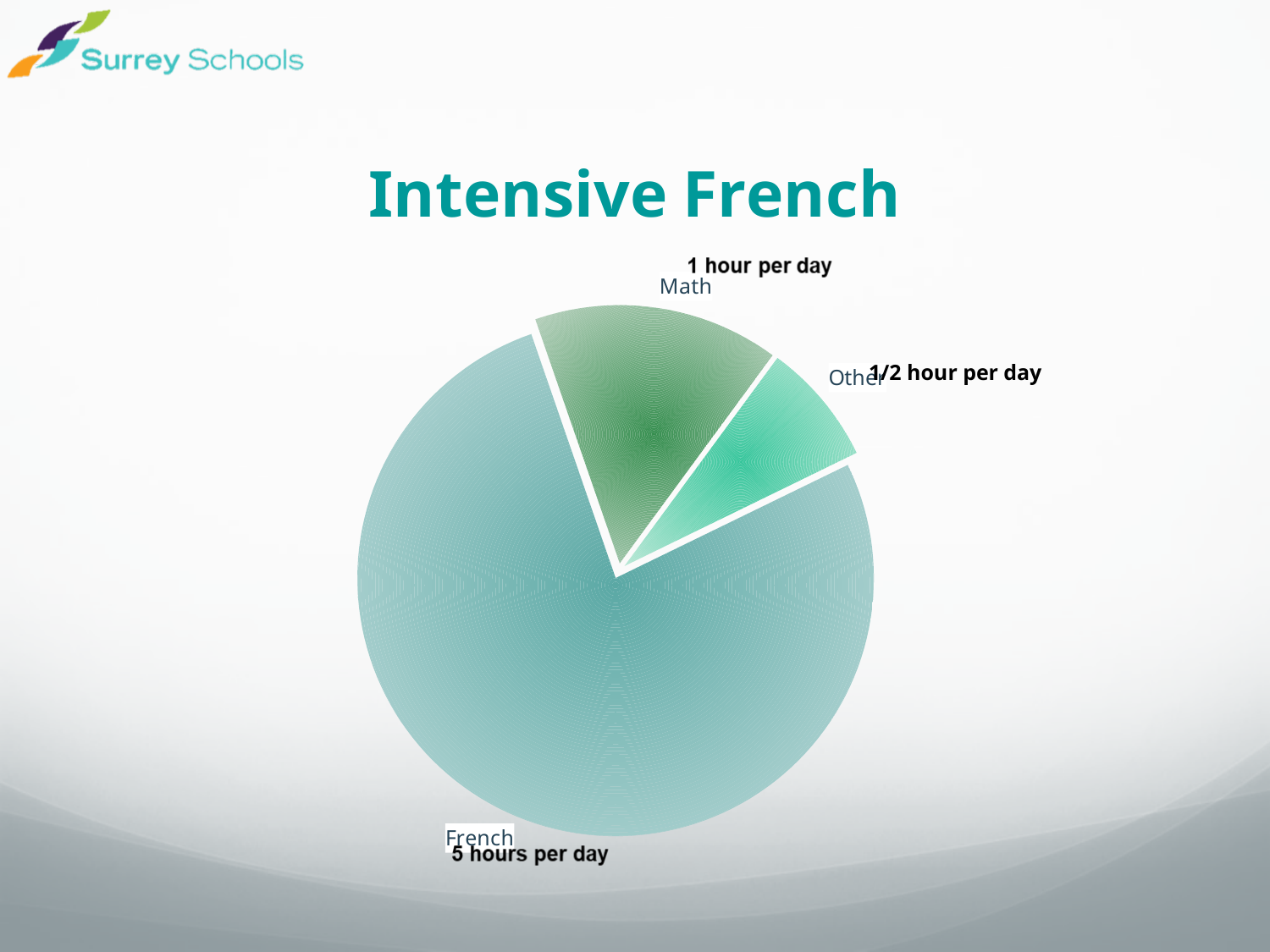
What is the title of the chart? Intensive French Which gets more time per day, Math or Other? Math How much time per day is shown for French? 5 hours per day Which category takes up the smallest slice of the pie? Other How much time per day is shown for Other? 1/2 hour per day What are the three categories labelled on the pie chart? French, Math, Other How many more hours per day does French get than Math? 4 hours How many slices does the pie chart have? 3 Which subject takes up the largest slice of the pie? French What kind of chart is shown on the slide? pie chart Which slice is larger, French or Math? French How much time per day is shown for Math? 1 hour per day